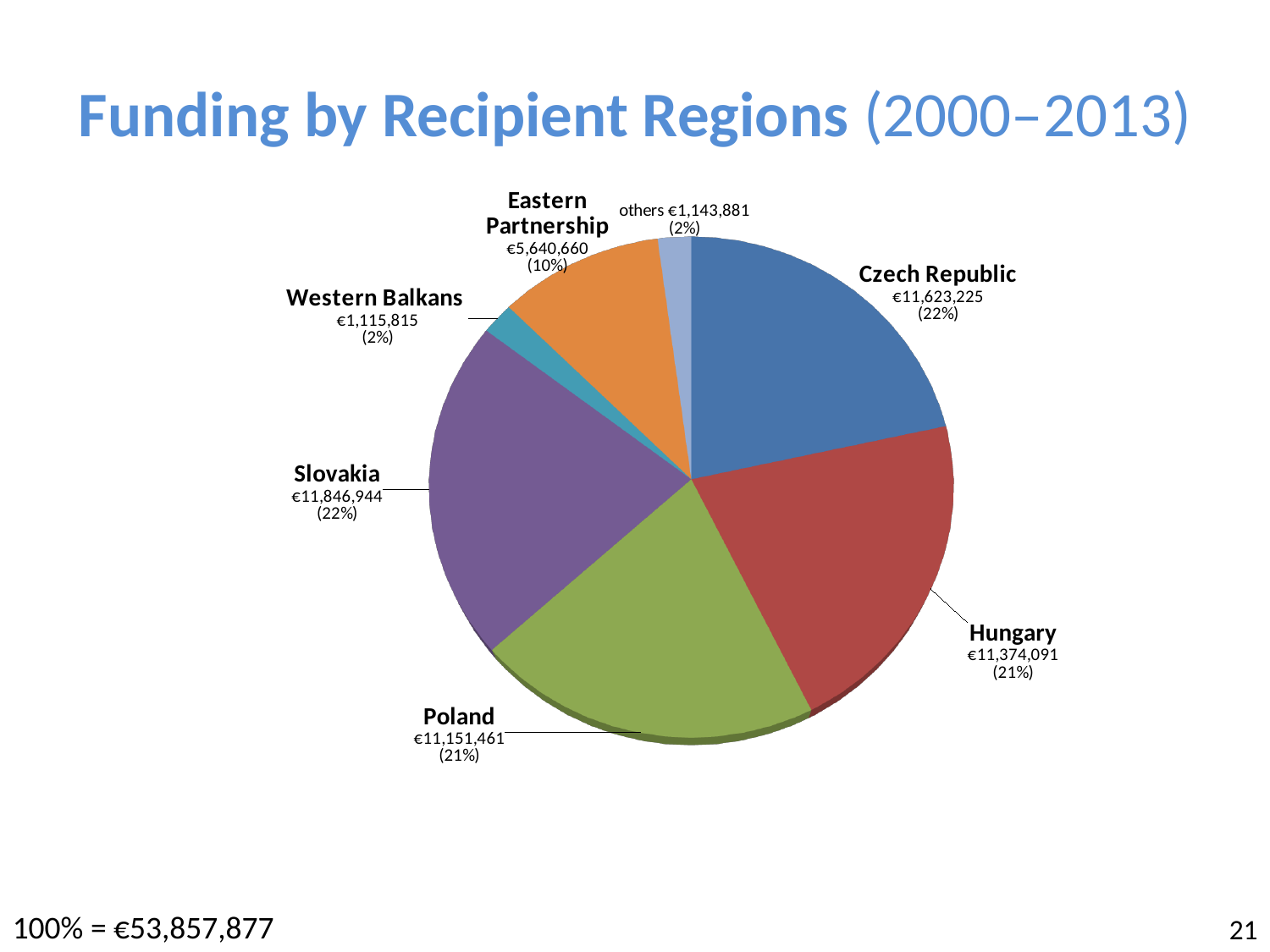
What type of chart is shown on the slide? pie chart What is the difference in funding between Slovakia and the Czech Republic? €223,719 How much funding did the Czech Republic receive? €11,623,225 How many slices does the pie chart have? 7 Which recipient region received the most funding? Slovakia What is the title of the chart on the slide? Funding by Recipient Regions (2000–2013) What percentage of funding went to Eastern Partnership? 10% Which received more funding, Hungary or Poland? Hungary Which recipient region received the least funding? Western Balkans What share of the pie does Hungary represent? 21% What is the funding value for Eastern Partnership? €5,640,660 What is the difference in funding between Eastern Partnership and Western Balkans? €4,524,845